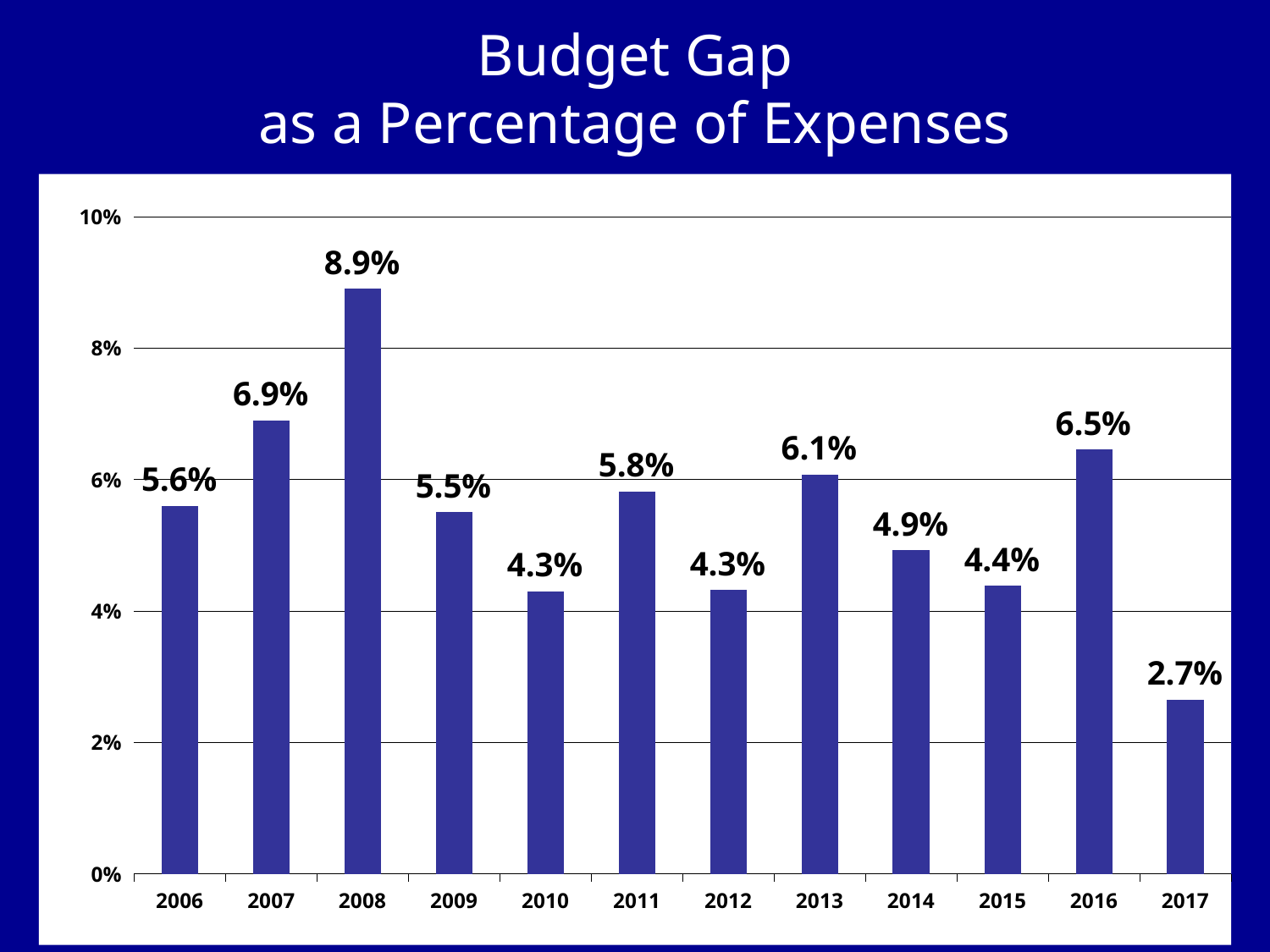
How many years are shown on the chart? 12 What kind of chart is shown on the slide? Bar chart Which year has the highest budget gap as a percentage of expenses? 2008 What is the budget gap as a percentage of expenses in 2008? 8.9% What is the budget gap as a percentage of expenses in 2017? 2.7% Does the budget gap percentage rise or fall from 2016 to 2017? Fall Which year has a larger budget gap percentage, 2007 or 2016? 2007 Which year has the lowest budget gap as a percentage of expenses? 2017 Is the value for 2014 greater or less than 4%? greater What is the difference between the budget gap percentage in 2008 and in 2017? 6.2% What is the title of the chart? Budget Gap as a Percentage of Expenses What is the budget gap as a percentage of expenses in 2013? 6.1%